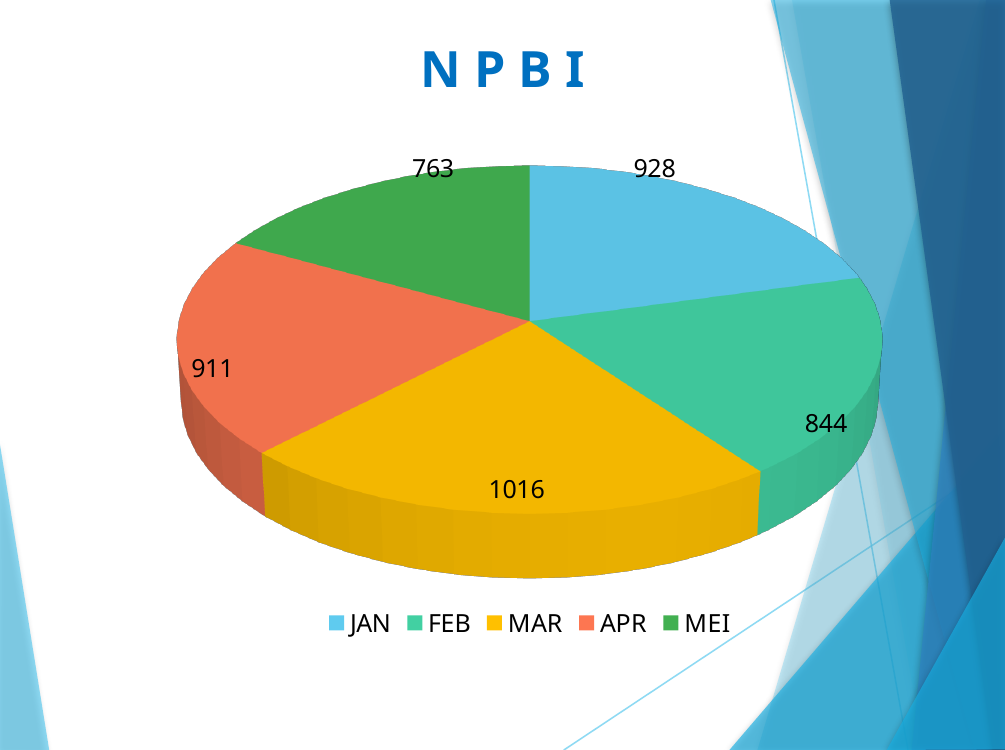
What is the total of all slices in the N P B I pie chart? 4462 Which is larger in the N P B I pie chart, JAN or FEB? JAN What is the value for MEI in the N P B I pie chart? 763 How many slices does the N P B I pie chart have? 5 What is the title of the chart on the slide? N P B I What is the value for MAR in the N P B I pie chart? 1016 What is the difference between the values for MAR and MEI in the N P B I pie chart? 253 What is the value for JAN in the N P B I pie chart? 928 What is the value for APR in the N P B I pie chart? 911 Which month has the smallest slice in the N P B I pie chart? MEI What kind of chart is shown on the slide? Pie chart Which month has the largest slice in the N P B I pie chart? MAR